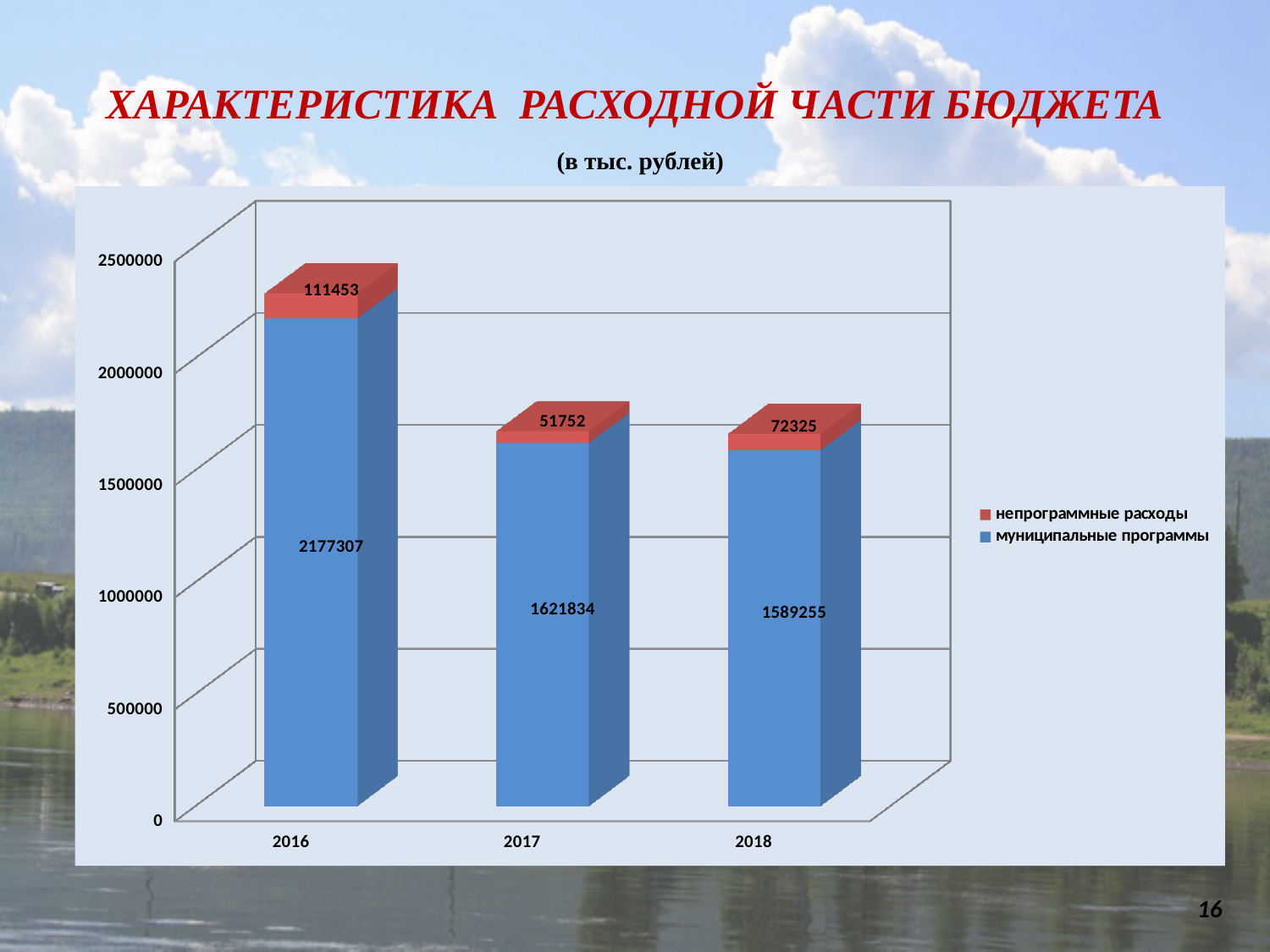
What is the total of the stacked bar for 2018? 1661580 What kind of chart is shown on the slide? Stacked bar chart What is the total of the stacked bar for 2016? 2288760 Which is larger: муниципальные программы in 2017 or in 2018? 2017 What is the difference between the непрограммные расходы values for 2018 and 2017? 20573 In which year is the value for непрограммные расходы the lowest? 2017 In which year is the value for муниципальные программы the highest? 2016 What is the difference between the муниципальные программы values for 2016 and 2017? 555473 How many series does the legend list? 2 What is the value for муниципальные программы in 2016? 2177307 What is the value for непрограммные расходы in 2017? 51752 What is the value for непрограммные расходы in 2018? 72325